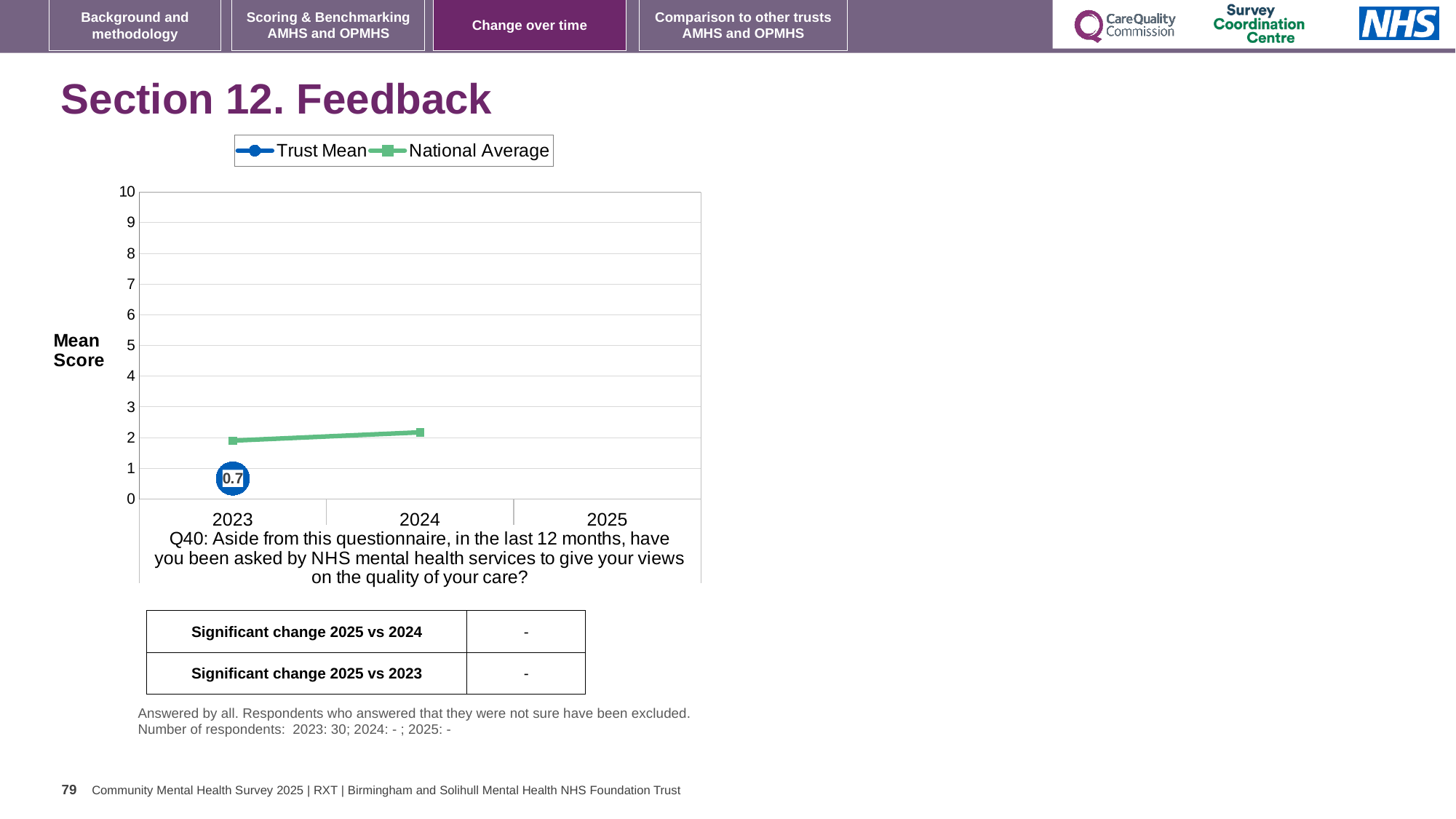
Is the National Average value for 2024 greater or less than 1? greater What is the Trust Mean value for 2023? 0.7 In 2023, which is larger: the Trust Mean or the National Average? National Average What kind of chart is shown on the slide? line chart What is the label on the y axis? Mean Score How many years are shown on the x axis? 3 Is the National Average value for 2023 greater or less than 3? less What are the two series named in the legend? Trust Mean and National Average How many series does the legend list? 2 Is the Trust Mean value for 2023 greater or less than 1? less In which year is the National Average highest? 2024 Does the National Average rise or fall from 2023 to 2024? rise